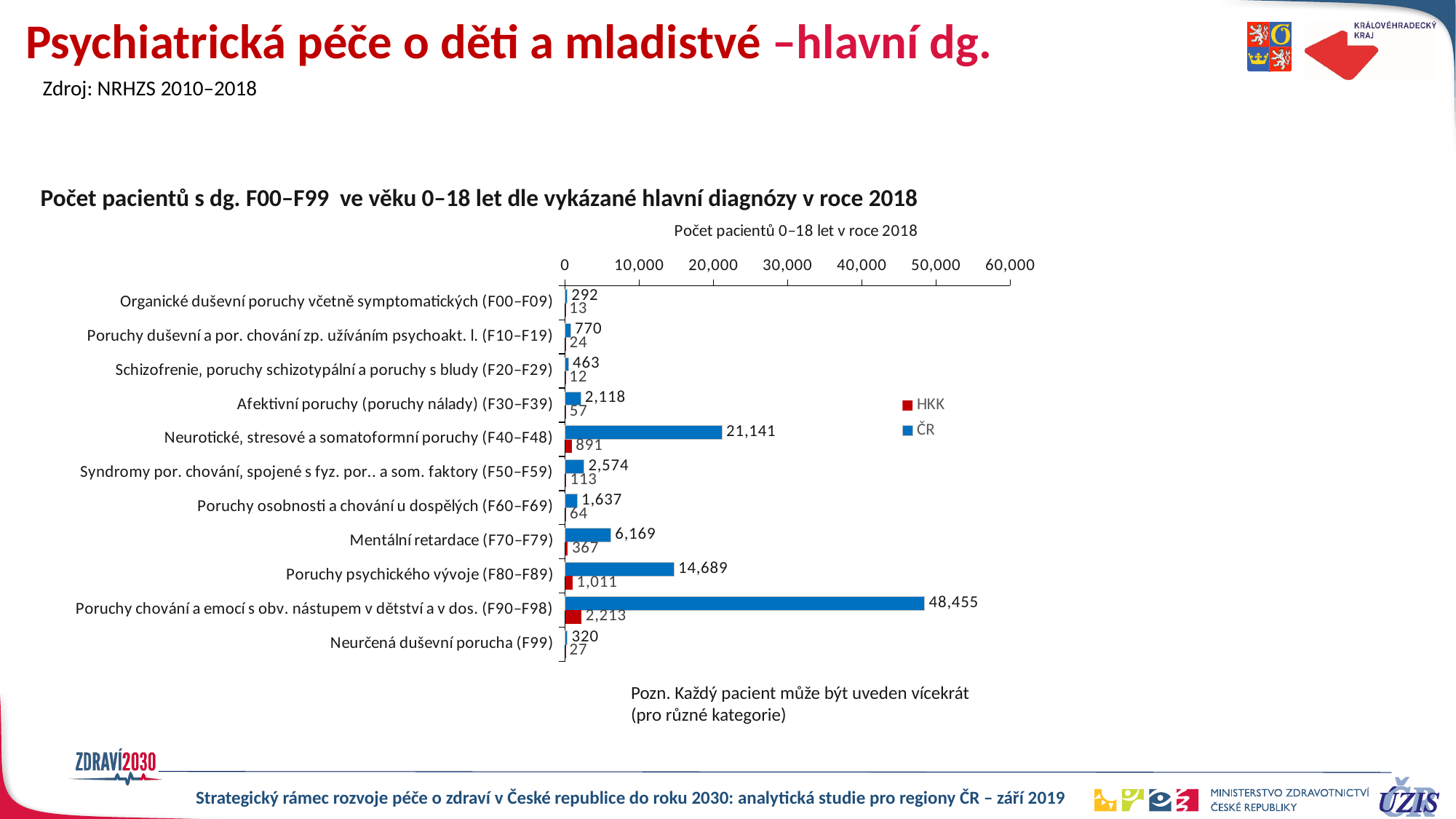
What is the ČR value for Poruchy chování a emocí s obv. nástupem v dětství a v dos. (F90–F98)? 48,455 Is the ČR value for Neurotické, stresové a somatoformní poruchy (F40–F48) greater or less than 20,000? greater How many diagnosis groups are shown on the chart? 11 What is the HKK value for Poruchy psychického vývoje (F80–F89)? 1,011 What is the HKK value for Neurotické, stresové a somatoformní poruchy (F40–F48)? 891 What is the difference between the ČR and HKK values for Poruchy chování a emocí s obv. nástupem v dětství a v dos. (F90–F98)? 46,242 How many series does the legend list? 2 What is the ČR value for Mentální retardace (F70–F79)? 6,169 Which diagnosis group has the highest ČR value? Poruchy chování a emocí s obv. nástupem v dětství a v dos. (F90–F98) Which is larger: the ČR value for Neurotické, stresové a somatoformní poruchy (F40–F48) or the ČR value for Poruchy psychického vývoje (F80–F89)? Neurotické, stresové a somatoformní poruchy (F40–F48) Which diagnosis group has the lowest HKK value? Schizofrenie, poruchy schizotypální a poruchy s bludy (F20–F29) What kind of chart is shown on the slide? bar chart